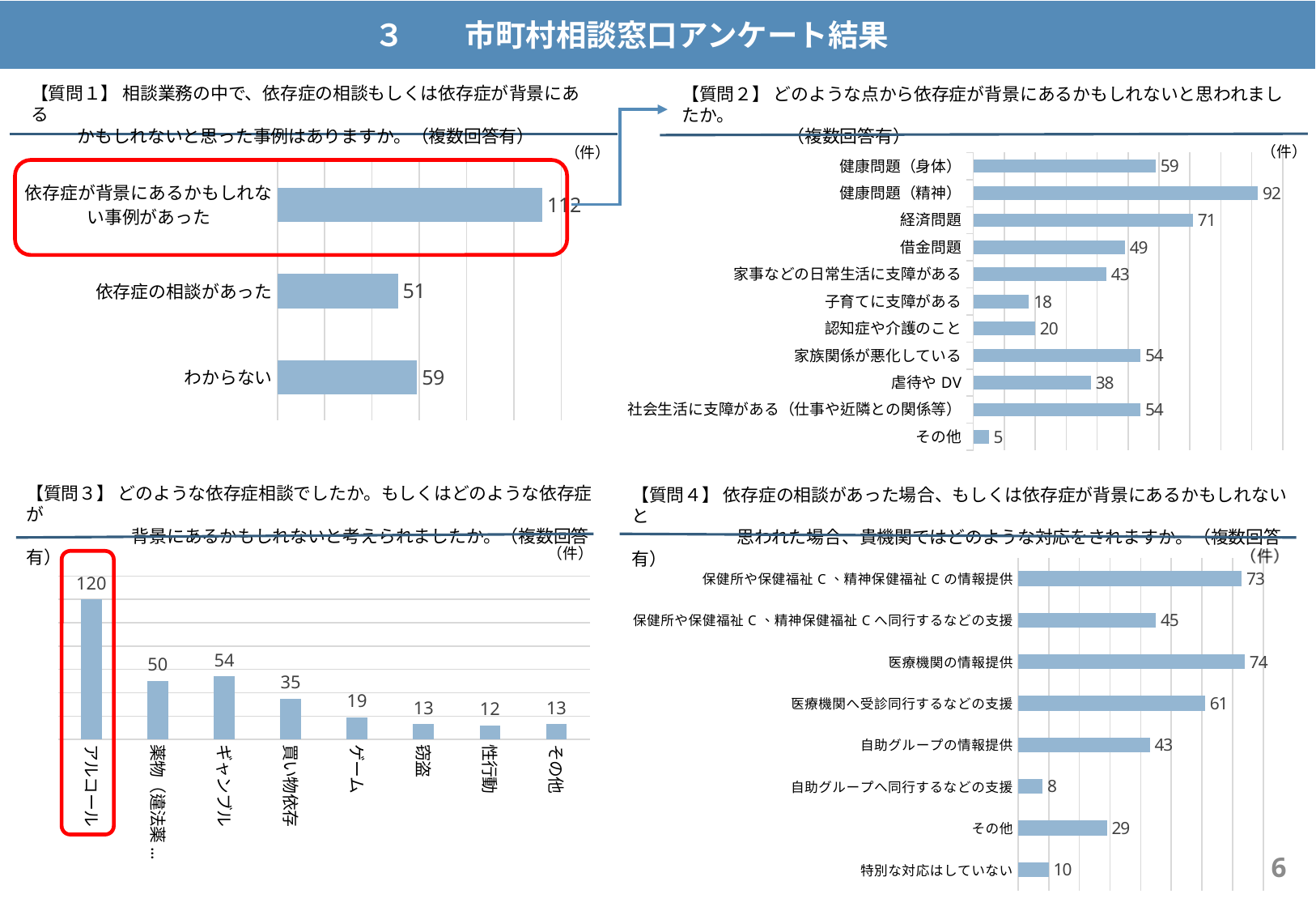
What type of chart is the 【質問3】 chart? bar chart How many categories are shown in the 【質問2】 chart? 11 In the 【質問4】 chart, which is larger: 医療機関の情報提供 or 医療機関へ受診同行するなどの支援? 医療機関の情報提供 In the 【質問2】 chart, which category has the highest value? 健康問題（精神） In the 【質問2】 chart, what is the value for 借金問題? 49 In the 【質問1】 chart, what is the difference between わからない and 依存症の相談があった? 8 In the 【質問3】 chart, what is the value for ギャンブル? 54 In the 【質問2】 chart, which category has the lowest value? その他 In the 【質問4】 chart, what is the value for 自助グループへ同行するなどの支援? 8 In the 【質問3】 chart, what is the difference between アルコール and 薬物? 70 In the 【質問3】 chart, which category has the highest value? アルコール In the 【質問1】 chart, what is the value for 依存症が背景にあるかもしれない事例があった? 112